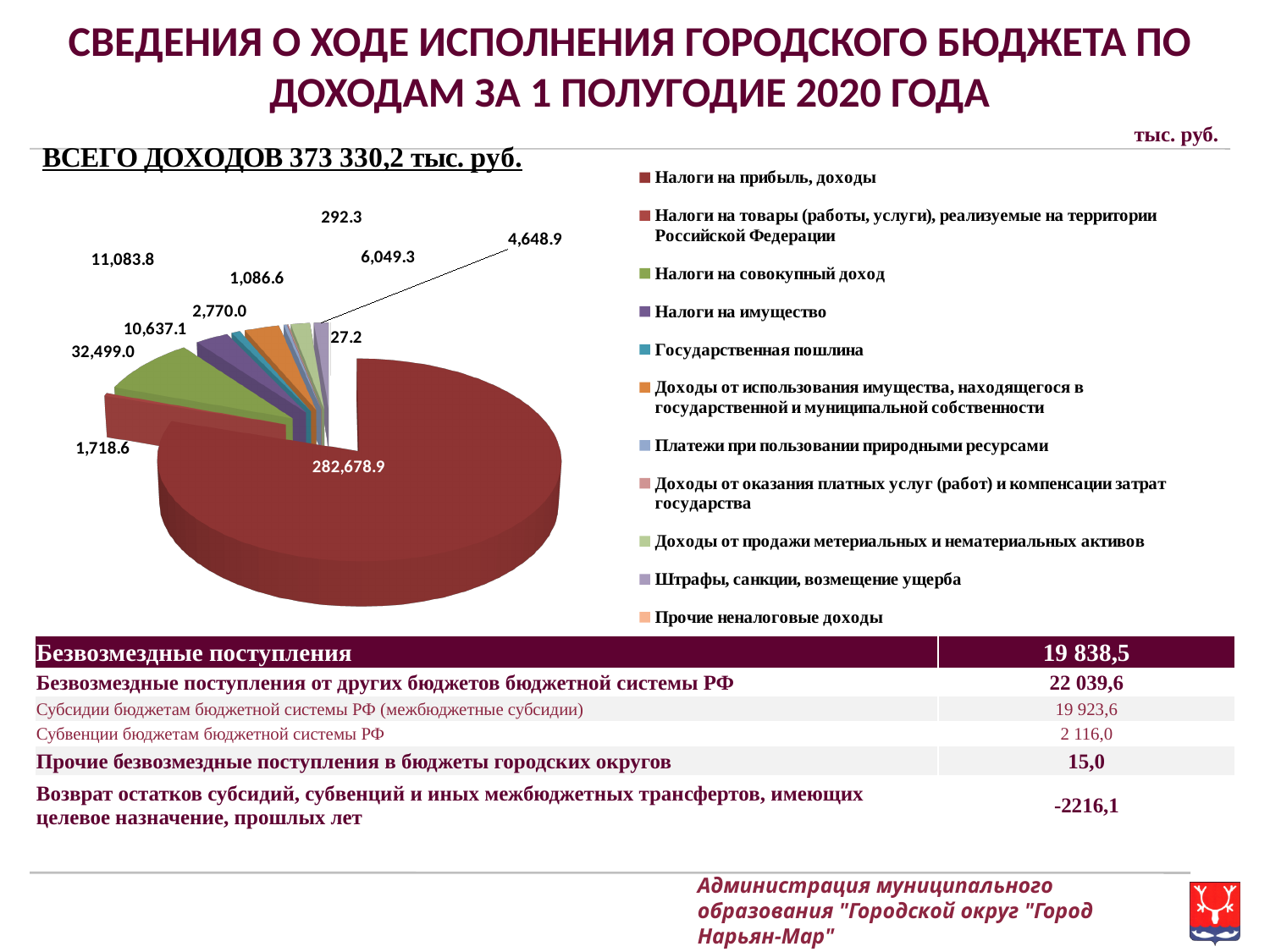
What is the value of the largest slice in the pie chart? 282,678.9 What is the value for Налоги на имущество in the pie chart? 10,637.1 What total income is stated in the heading above the pie chart? 373 330,2 тыс. руб. What unit is indicated for the values on the slide? тыс. руб. What kind of chart is shown on the slide? pie chart Which category has the largest slice in the pie chart? Налоги на прибыль, доходы What is the value for Налоги на совокупный доход in the pie chart? 32,499.0 What is the difference between the values for Налоги на совокупный доход (32,499.0) and Налоги на имущество (10,637.1)? 21,861.9 Which is larger in the pie chart: Налоги на совокупный доход or Налоги на имущество? Налоги на совокупный доход What is the smallest value labelled on the pie chart? 27.2 How many slices does the pie chart have? 11 How many entries does the legend of the pie chart list? 11